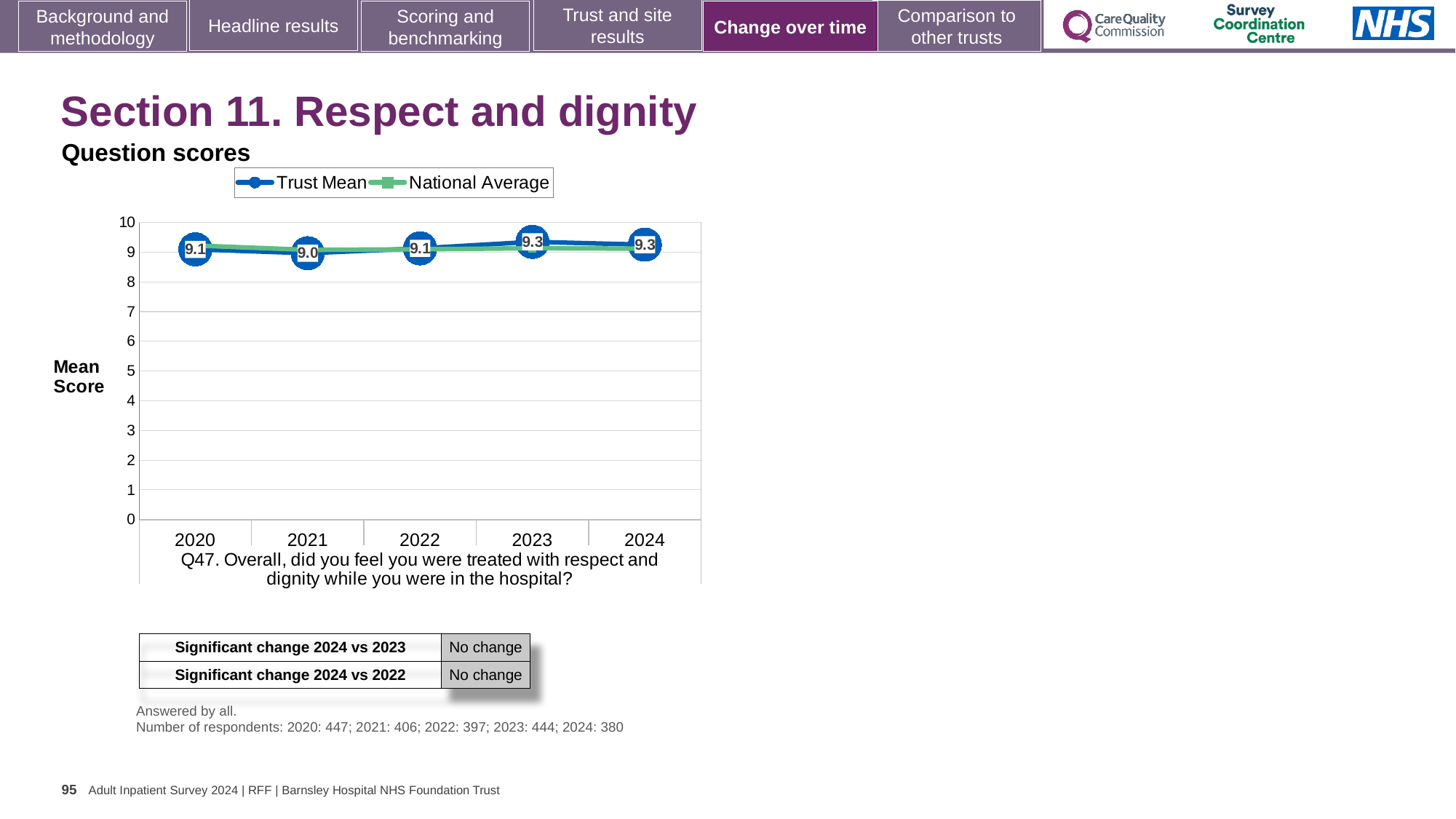
What is the label on the y axis of the chart? Mean Score What is the Trust Mean score for 2024? 9.3 Does the Trust Mean score rise or fall from 2021 to 2024? Rise Is the National Average value for 2022 greater or less than 8? greater What is the Trust Mean score for 2020? 9.1 How many years are plotted on the x axis? 5 What kind of chart is shown? Line chart In which year is the Trust Mean score lowest? 2021 How many series does the legend list? 2 Which is larger, the Trust Mean score for 2023 or for 2021? 2023 What is the difference between the Trust Mean score in 2024 and in 2021? 0.3 What is the Trust Mean score for 2021? 9.0